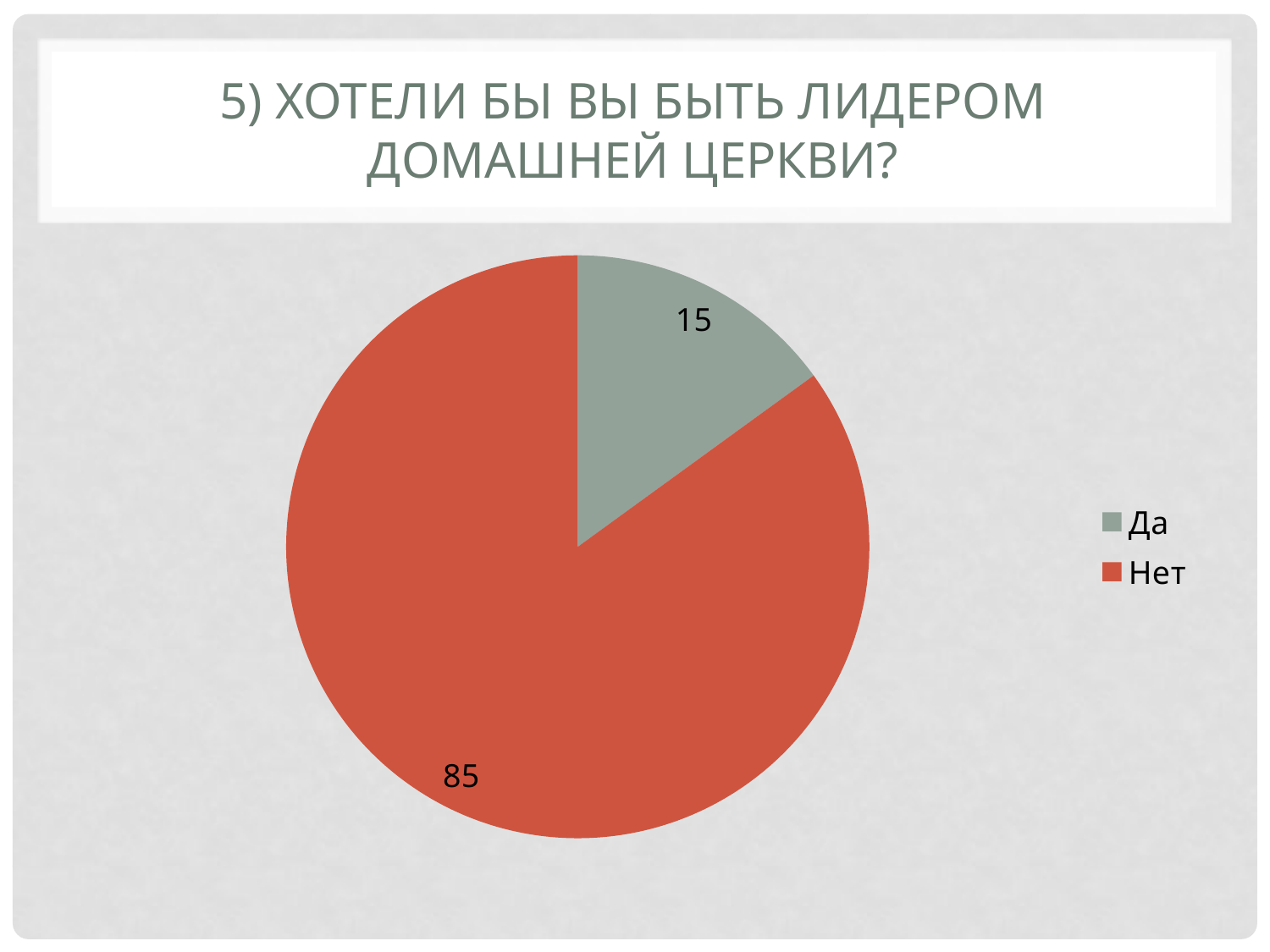
What is the value for Нет? 85 What share of the pie does the Да slice represent? 15% What is the value for Да? 15 Which category has the largest slice? Нет Which category has the smallest slice? Да What colour is the Нет slice? red Which is larger, the value for Да or the value for Нет? Нет What kind of chart is shown on the slide? pie chart What is the difference between the values for Нет and Да? 70 How many slices does the pie chart have? 2 What is the total of the two slice values? 100 How many entries does the legend list? 2